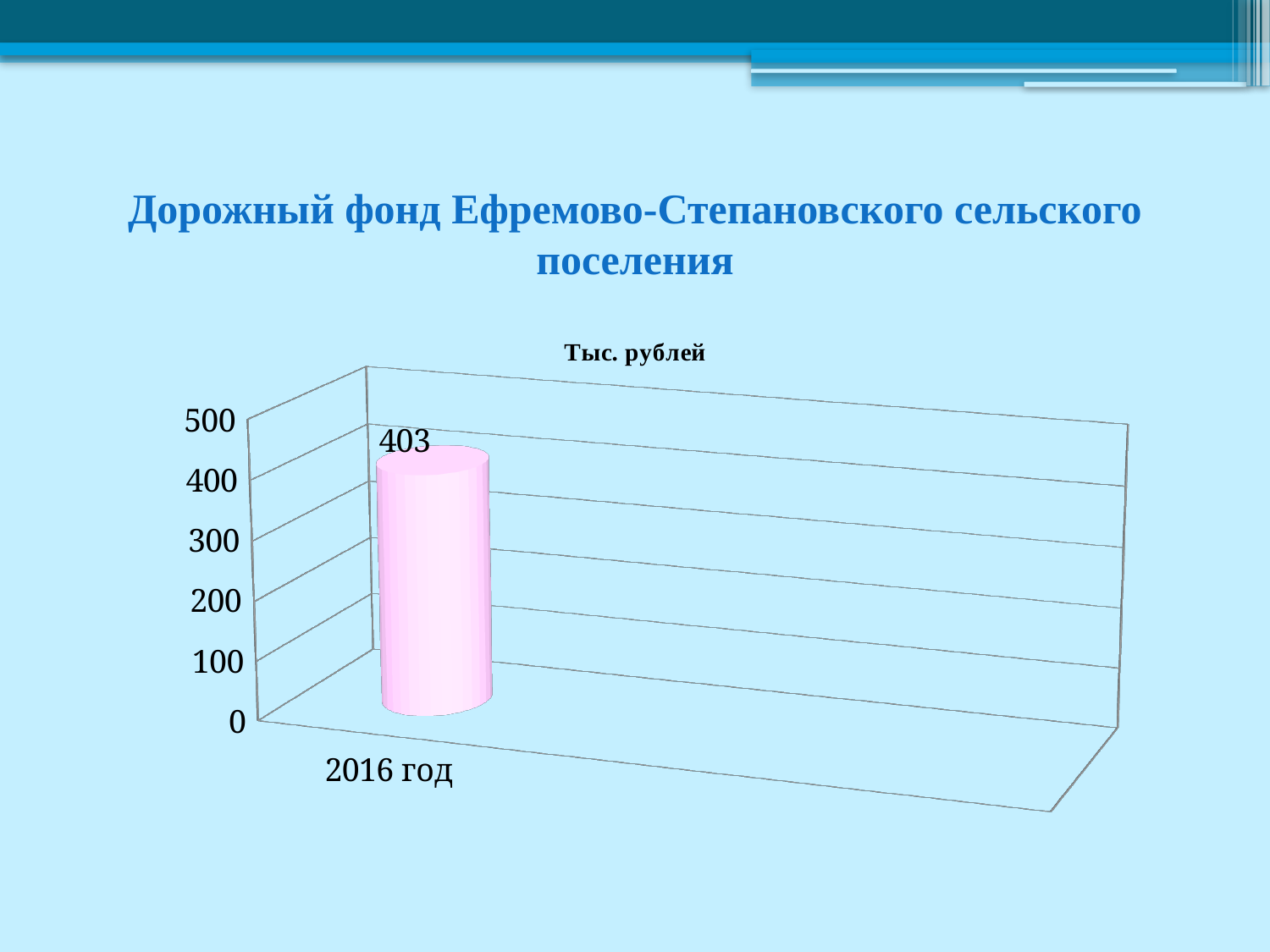
How many categories are plotted on the chart? 1 What is the value for 2016 год? 403 Is the value for 2016 год greater or less than 500? less What is the highest value shown on the vertical axis? 500 What is the title of the chart? Тыс. рублей What kind of chart is shown on the slide? bar chart Is the value for 2016 год greater or less than 400? greater Which category is shown on the x axis? 2016 год